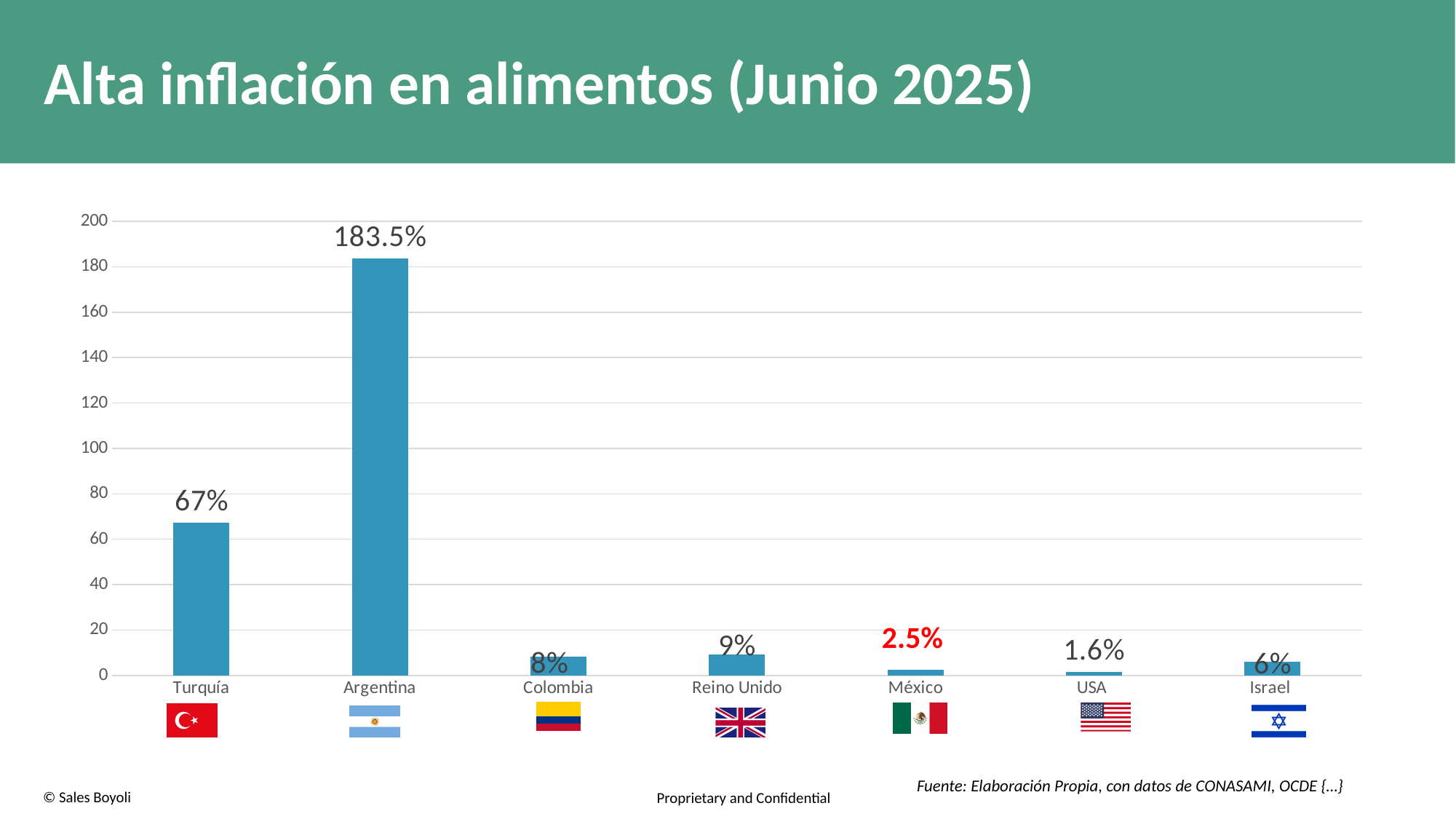
What is the value for Turquía? 67% What is the value for Argentina? 183.5% What is the value for México? 2.5% How many countries are shown in the chart? 7 Which country's data label is shown in red? México What is the value for USA? 1.6% What kind of chart is shown on the slide? Bar chart Which country has the lowest value? USA Which is larger, the value for Israel or the value for México? Israel Which country has the highest value? Argentina What is the difference between the values for Reino Unido and Colombia? 1% What is the difference between the values for Argentina and Turquía? 116.5%